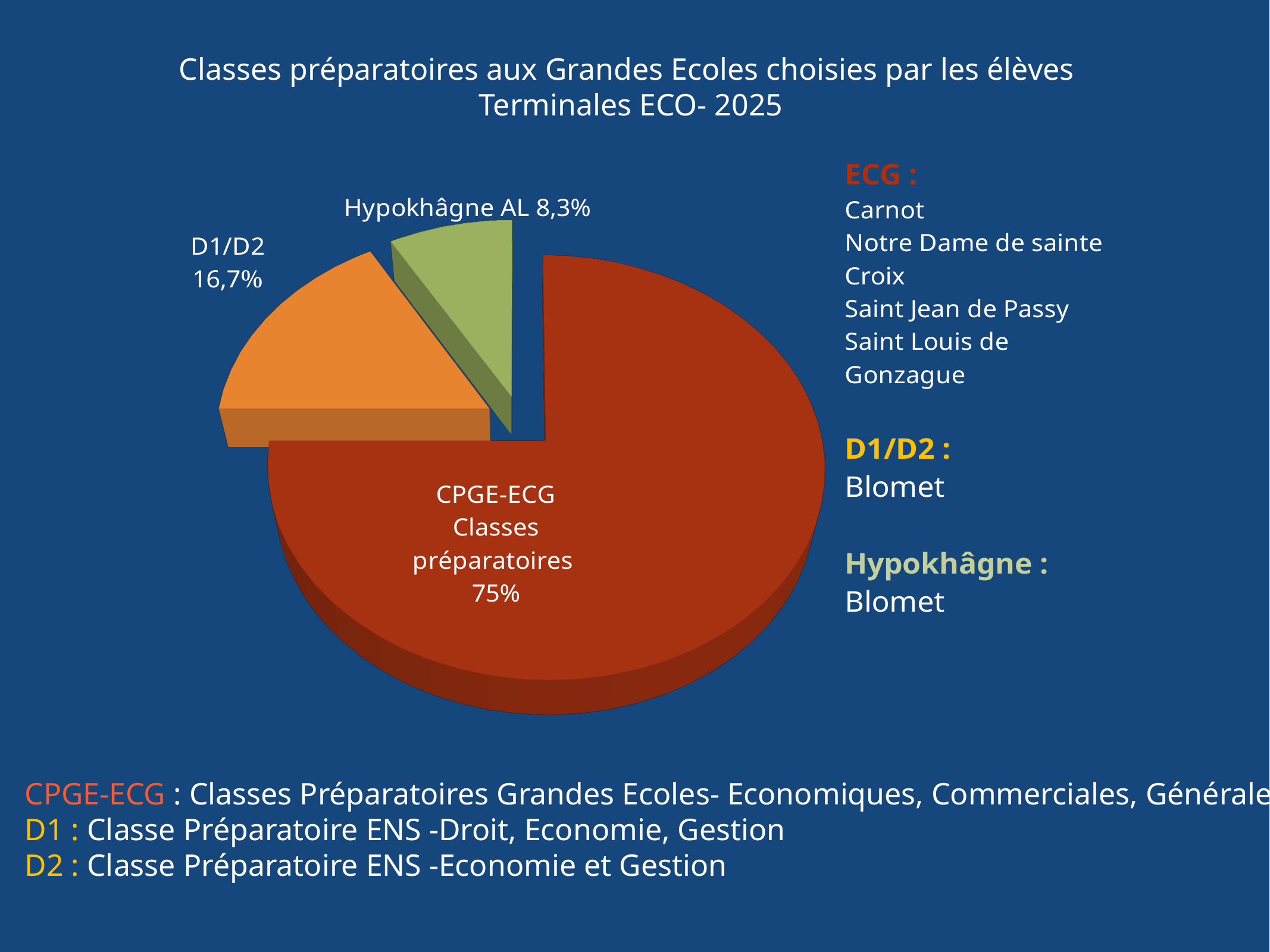
How many slices does the pie chart have? 3 Which slice of the pie is the smallest? Hypokhâgne AL What share of the pie does Hypokhâgne AL represent? 8,3% What share of the pie does CPGE-ECG Classes préparatoires represent? 75% Which is larger, the D1/D2 slice or the Hypokhâgne AL slice? D1/D2 Which slice of the pie is the largest? CPGE-ECG Classes préparatoires What colour is the Hypokhâgne AL slice? Green What is the title of the chart? Classes préparatoires aux Grandes Ecoles choisies par les élèves Terminales ECO- 2025 What share of the pie does D1/D2 represent? 16,7% What is the difference in percentage points between the CPGE-ECG slice and the D1/D2 slice? 58,3 What is the difference in percentage points between the D1/D2 slice and the Hypokhâgne AL slice? 8,4 What kind of chart is shown on the slide? Pie chart